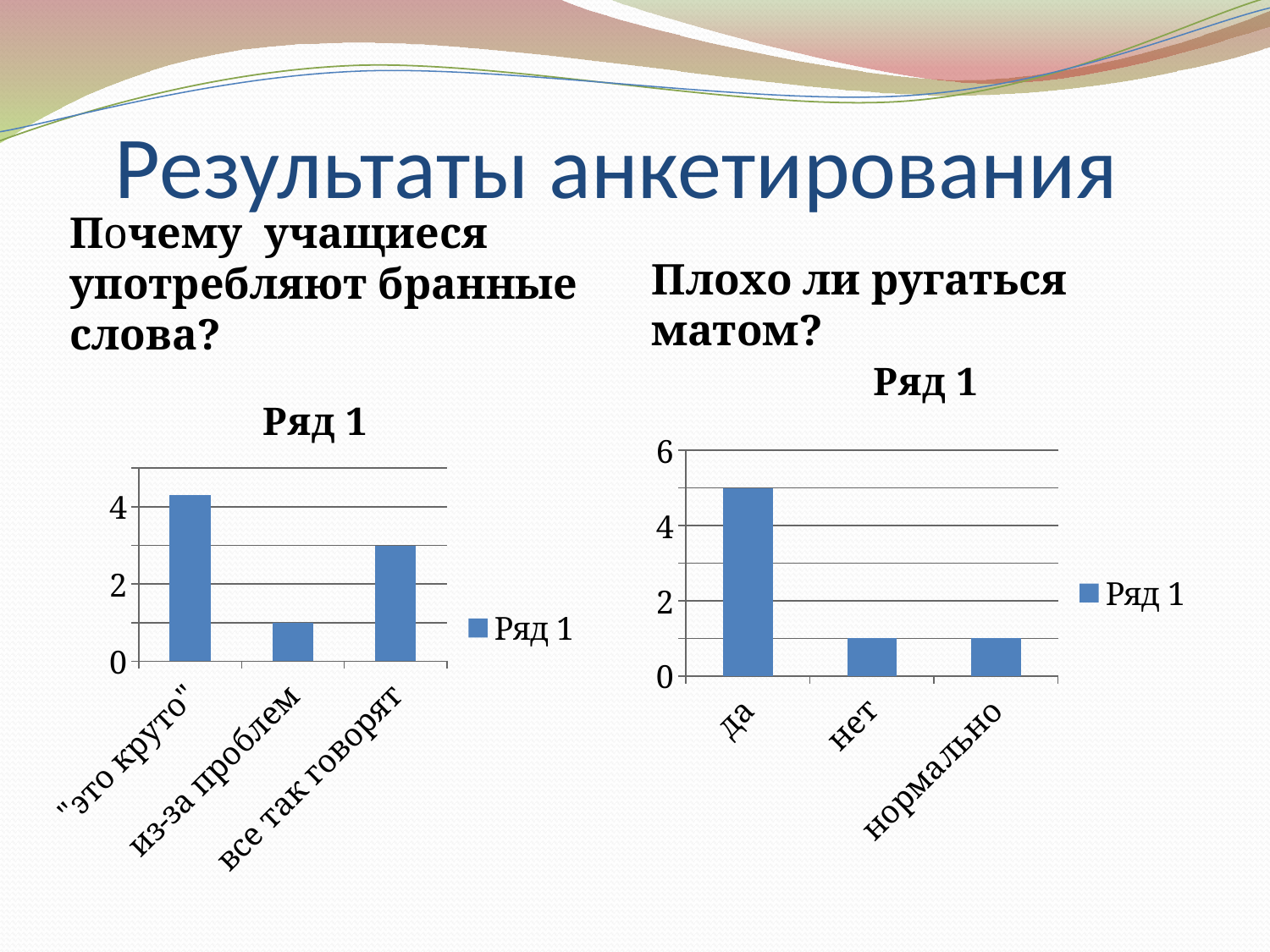
What is the legend entry shown in the right chart ("Плохо ли ругаться матом?")? Ряд 1 What kind of chart is the left chart titled "Почему учащиеся употребляют бранные слова?"? bar chart In the left chart ("Почему учащиеся употребляют бранные слова?"), which category has the lowest value? из-за проблем How many series does the legend of the left chart list? 1 In the left chart ("Почему учащиеся употребляют бранные слова?"), is the value for "все так говорят" greater or less than 2? greater In the left chart ("Почему учащиеся употребляют бранные слова?"), which category has the highest value? "это круто" In the left chart ("Почему учащиеся употребляют бранные слова?"), is the value for "из-за проблем" greater or less than 2? less In the right chart ("Плохо ли ругаться матом?"), how many categories are shown on the x axis? 3 In the right chart ("Плохо ли ругаться матом?"), which category has the highest value? да In the left chart ("Почему учащиеся употребляют бранные слова?"), which is larger: "это круто" or "все так говорят"? "это круто" In the right chart ("Плохо ли ругаться матом?"), is the value for "да" greater or less than 4? greater In the left chart ("Почему учащиеся употребляют бранные слова?"), how many categories are shown on the x axis? 3